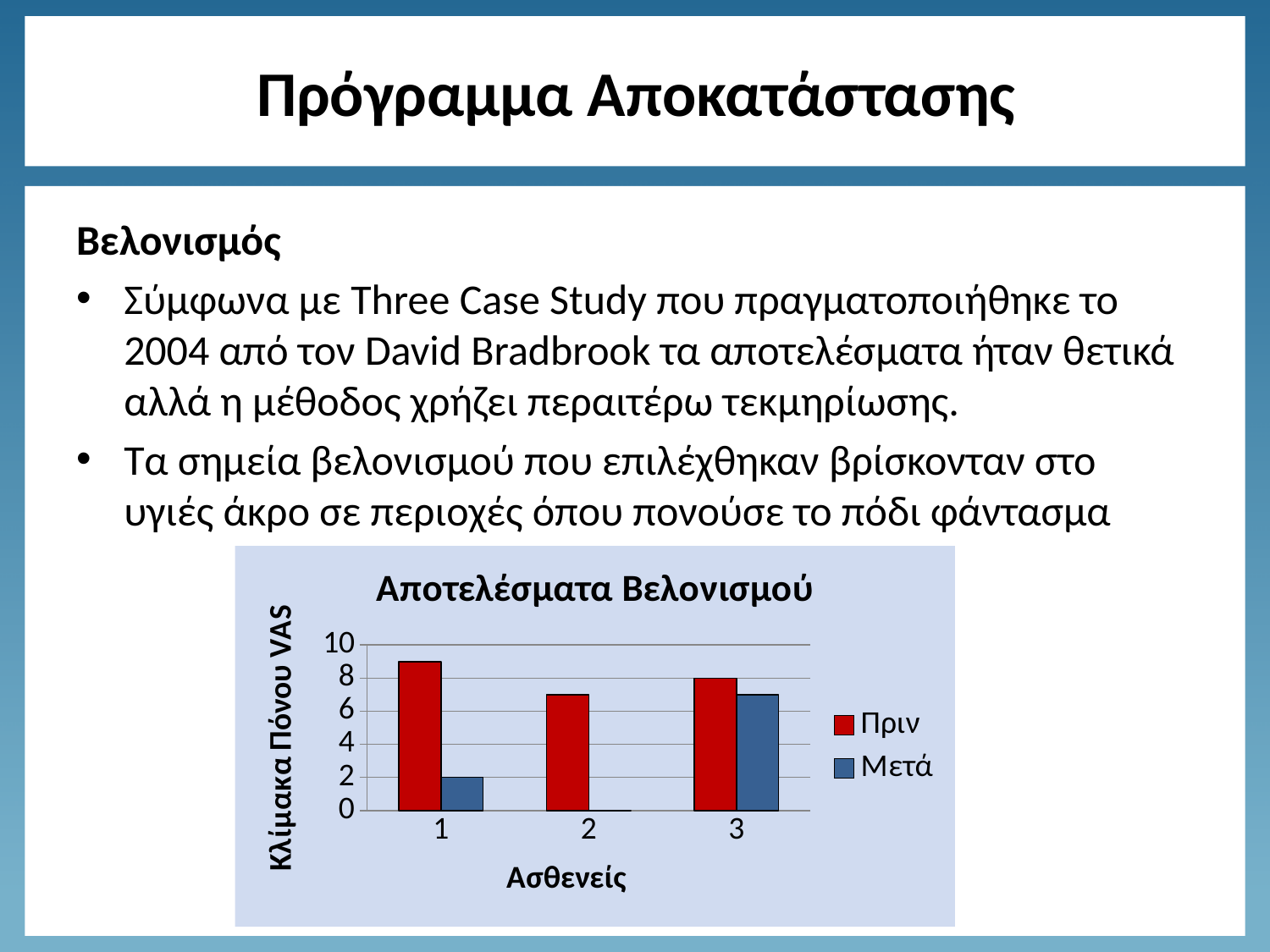
For patient 1, which is larger, the Πριν value or the Μετά value? Πριν What is the Μετά value for patient 1? 2 What type of chart is shown on the slide? bar chart What is the Πριν value for patient 3? 8 Is the Πριν value for patient 2 greater or less than 8? less Is the Πριν value for patient 1 greater or less than 8? greater What is the title of the chart? Αποτελέσματα Βελονισμού How many patients (categories) are shown on the x axis? 3 How many series does the chart legend list? 2 Which patient has the highest Πριν value? 1 What is the Μετά value for patient 2? 0 Which patient has the lowest Μετά value? 2